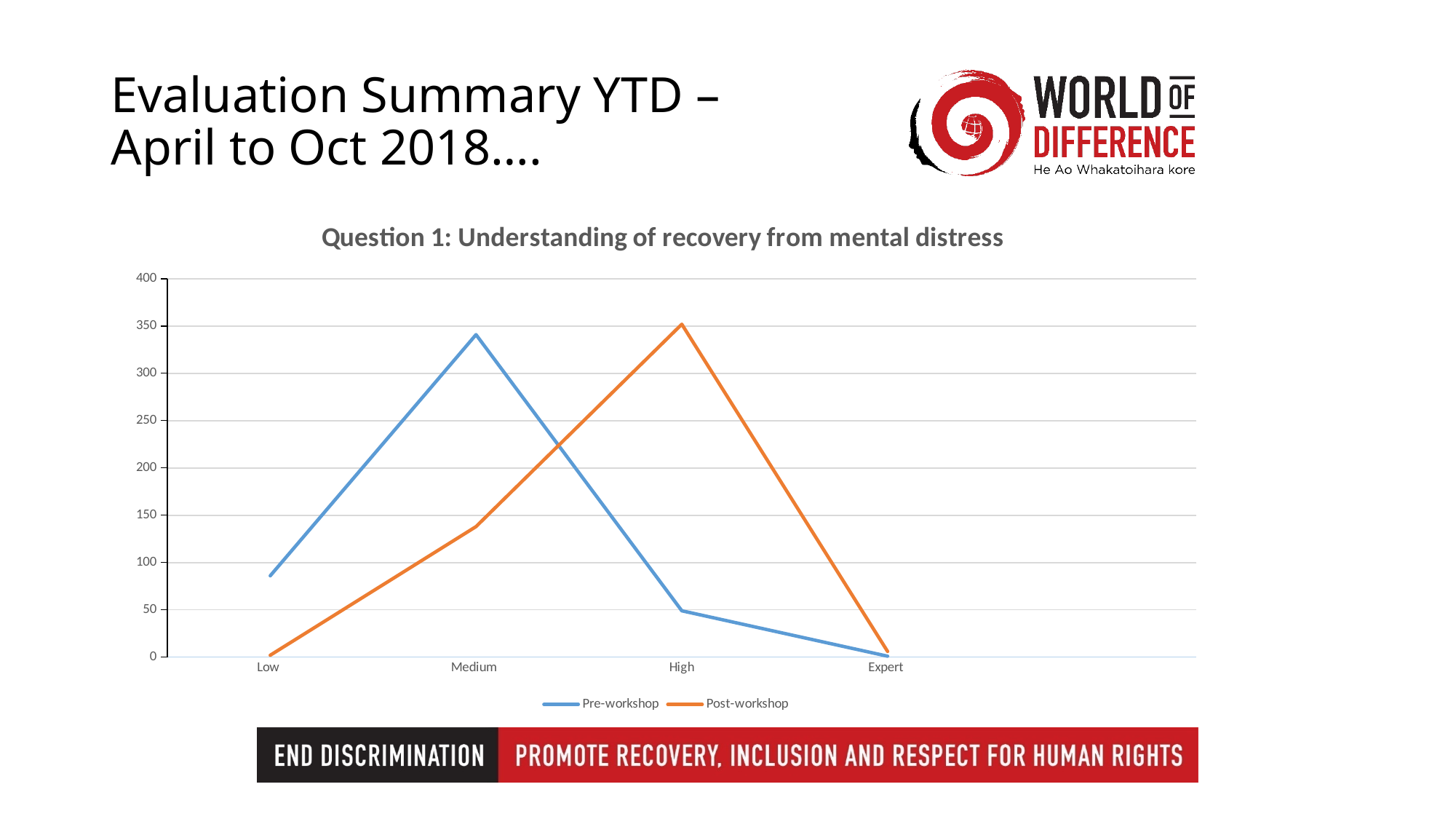
For the Pre-workshop series, which category has the lowest value? Expert For the Pre-workshop series, which category has the highest value? Medium What kind of chart is shown on the slide? line chart Is the Post-workshop value for Medium greater or less than 150? less Is the Pre-workshop value for Medium greater or less than 300? greater At the Medium category, which series has the larger value, Pre-workshop or Post-workshop? Pre-workshop For the Post-workshop series, which category has the highest value? High How many series does the legend list? 2 How many categories are shown on the x axis? 4 At the High category, which series has the larger value, Pre-workshop or Post-workshop? Post-workshop Does the Post-workshop line rise or fall from Low to High? rise